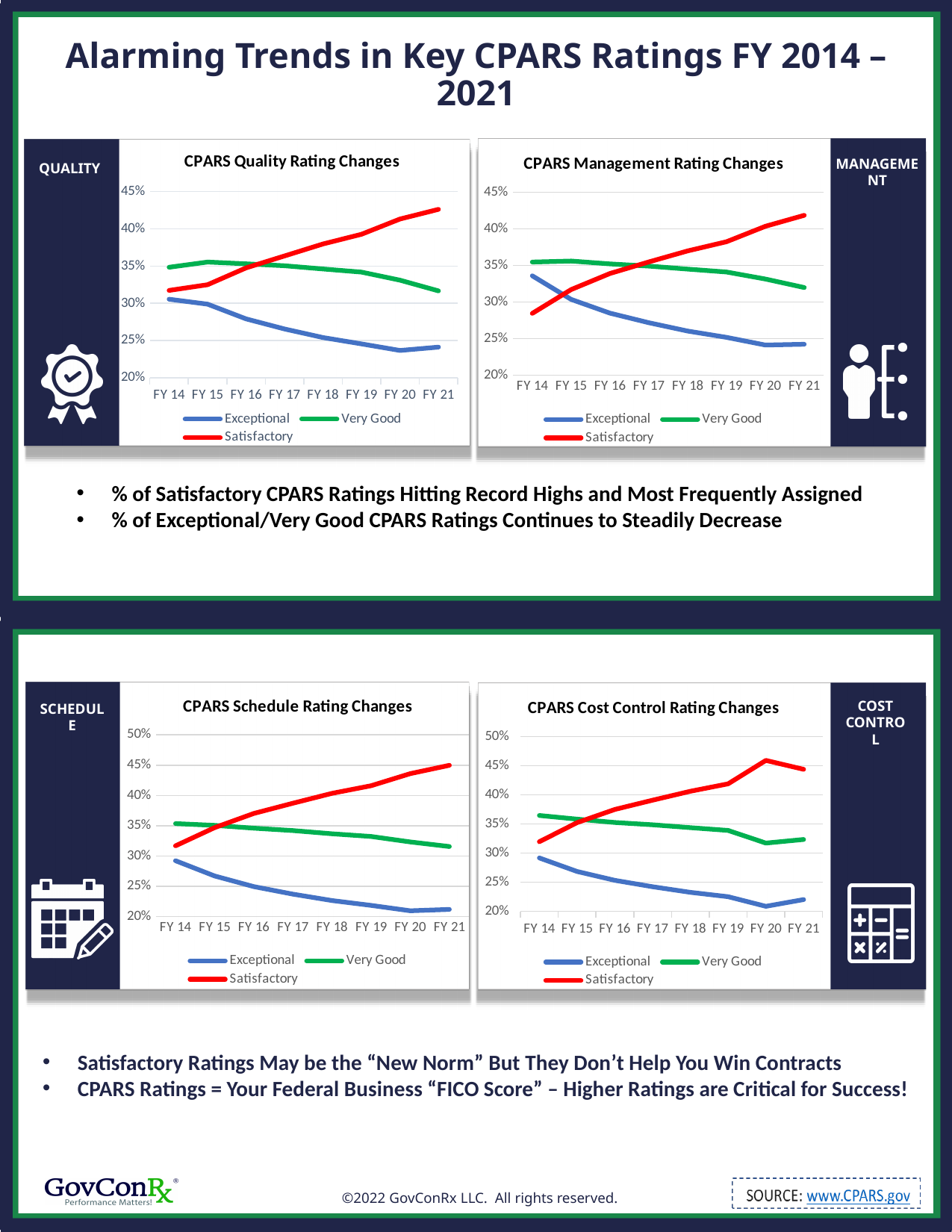
In the CPARS Quality Rating Changes chart, is the Satisfactory value for FY 21 greater or less than 40%? greater In the CPARS Schedule Rating Changes chart, which is larger in FY 21: Satisfactory or Exceptional? Satisfactory In the CPARS Management Rating Changes chart, does the Exceptional line rise or fall from FY 14 to FY 21? fall In the CPARS Management Rating Changes chart, which is larger in FY 14: Exceptional or Satisfactory? Exceptional What colour is the Satisfactory line in the CPARS Schedule Rating Changes chart? red In the CPARS Quality Rating Changes chart, does the Satisfactory line rise or fall from FY 14 to FY 21? rise In the CPARS Cost Control Rating Changes chart, in which fiscal year is the Satisfactory line at its highest? FY 20 How many fiscal years are plotted on the x axis of the CPARS Schedule Rating Changes chart? 8 In the CPARS Cost Control Rating Changes chart, is the Exceptional value for FY 20 greater or less than 25%? less How many series does the legend of the CPARS Management Rating Changes chart list? 3 What kind of chart is the CPARS Quality Rating Changes chart? line chart In the CPARS Management Rating Changes chart, is the Exceptional value for FY 14 greater or less than 30%? greater